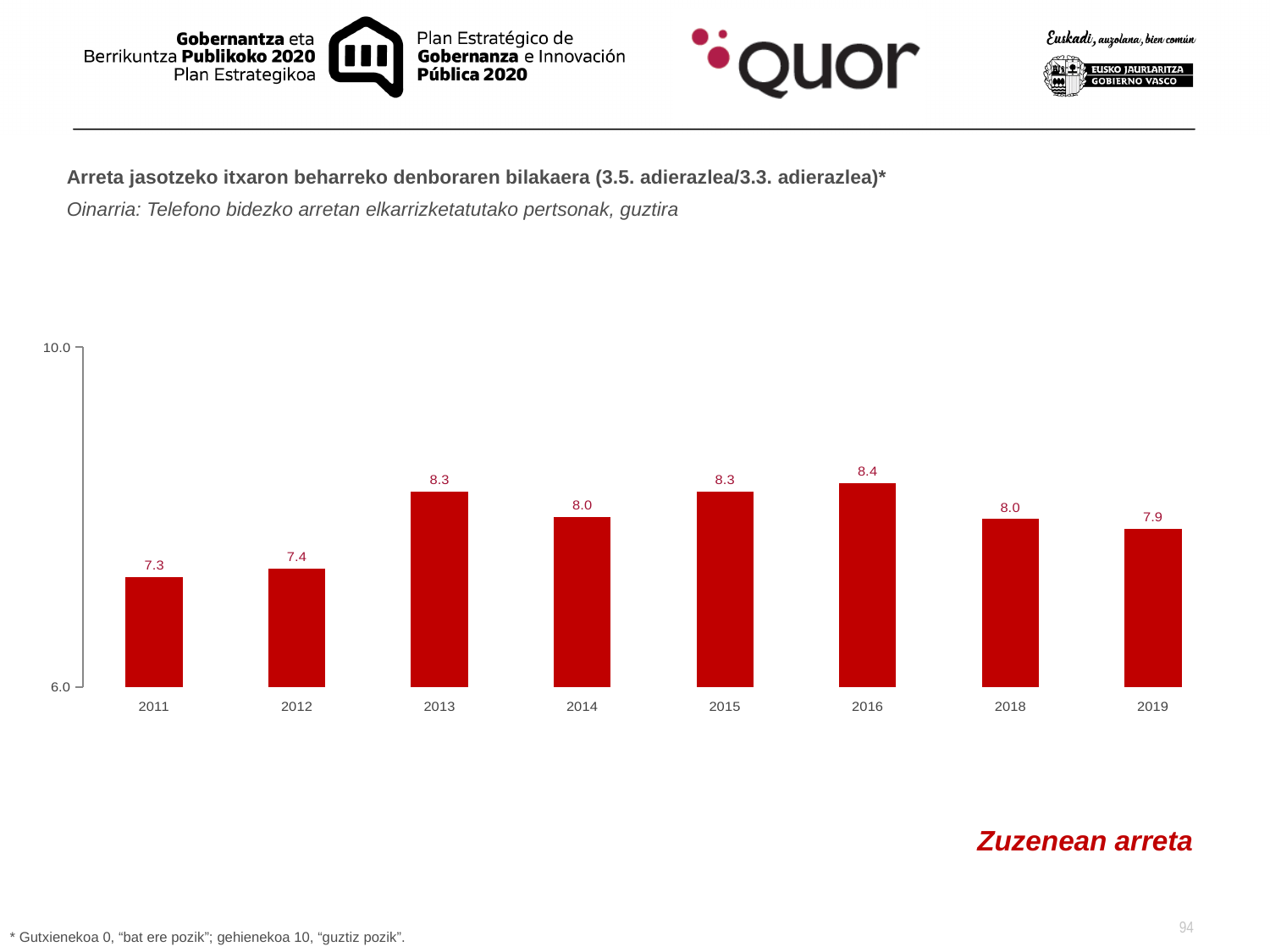
What kind of chart is this? bar chart What is the difference between the values for 2013 and 2014? 0.3 Which year has the lowest value? 2011 What is the value for 2016? 8.4 Which is larger, the value for 2012 or the value for 2018? 2018 Which year has the highest value? 2016 What colour are the bars? red What is the difference between the values for 2016 and 2011? 1.1 What is the value for 2011? 7.3 Does the value rise or fall from 2011 to 2013? rise What is the value for 2019? 7.9 How many years are shown on the x axis? 8